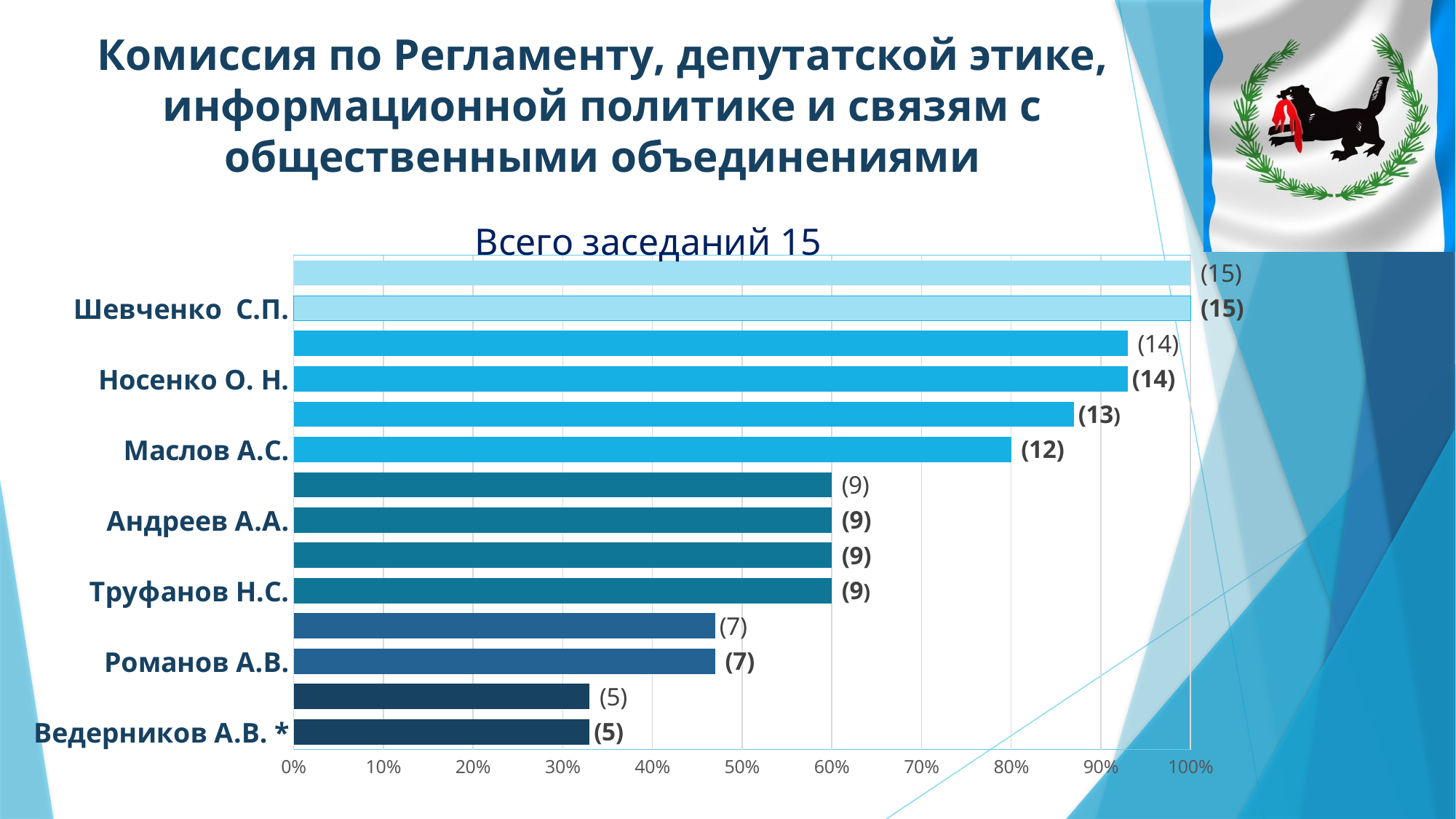
What kind of chart is shown on the slide? bar chart What is the title of the chart? Всего заседаний 15 What value is shown for Носенко О. Н.? (14) What value is shown for Шевченко С.П.? (15) What value is shown for Ведерников А.В. *? (5) Which is larger, the value for Носенко О. Н. or for Маслов А.С.? Носенко О. Н. What value is shown for Маслов А.С.? (12) What value is shown for Романов А.В.? (7) Among the named deputies, who has the highest value? Шевченко С.П. What is the difference between the values for Шевченко С.П. and Ведерников А.В. *? 10 Among the named deputies, who has the lowest value? Ведерников А.В. * Is the bar for Романов А.В. greater or less than 50%? less